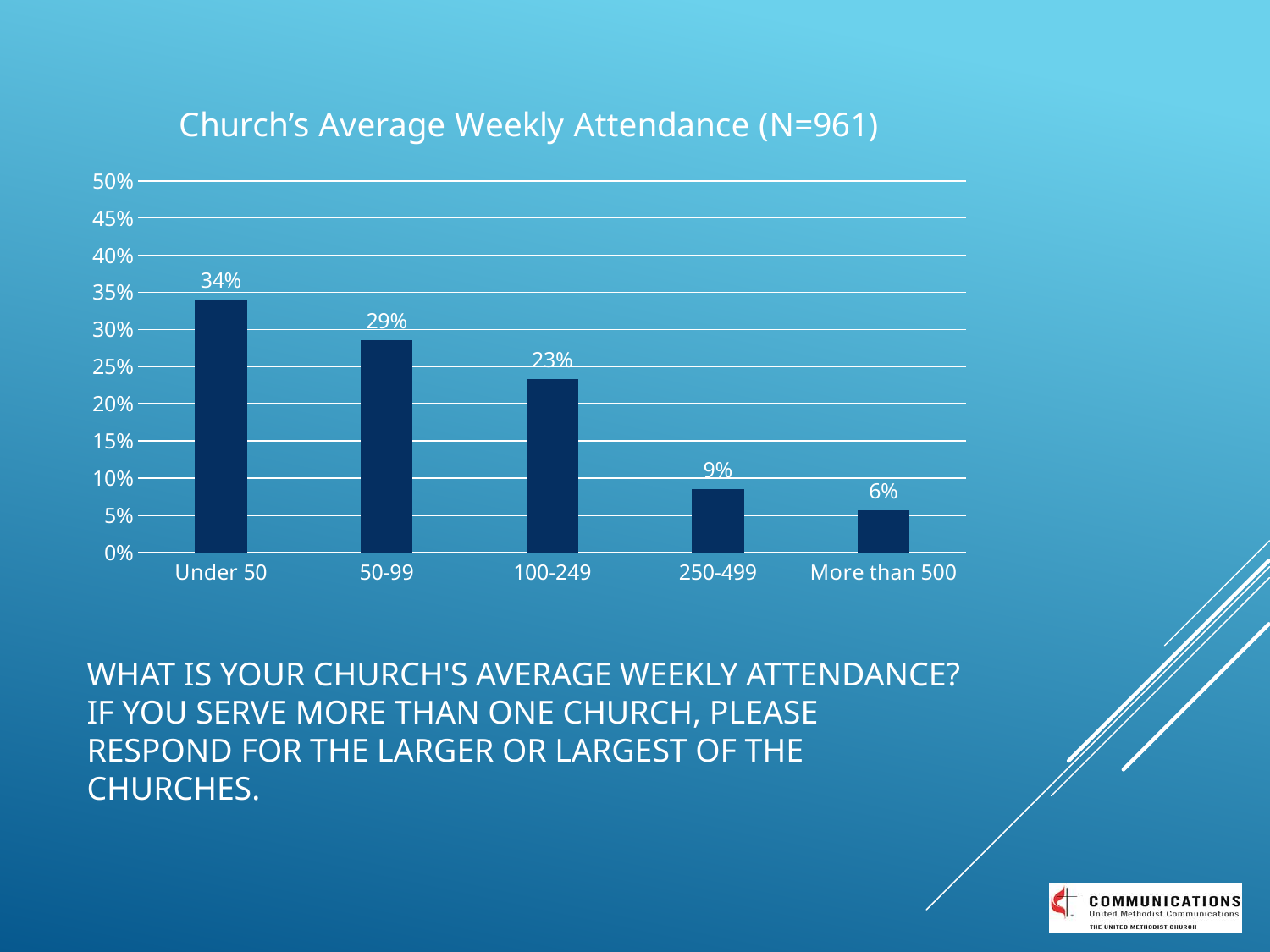
What is the difference in percentage points between the 250-499 and More than 500 categories? 3 Is the value for 250-499 greater or less than 10%? less What percentage of churches have an average weekly attendance of Under 50? 34% What is the value shown for the 100-249 attendance category? 23% Which attendance category has the lowest percentage? More than 500 How many attendance categories are shown on the chart? 5 Which category has a larger value, 50-99 or 100-249? 50-99 What is the difference in percentage points between the Under 50 and 50-99 categories? 5 Do the values rise or fall as the attendance categories increase from left to right? Fall What percentage is shown for churches with More than 500 in average weekly attendance? 6% Which attendance category has the highest percentage? Under 50 What kind of chart is shown on the slide? Bar chart